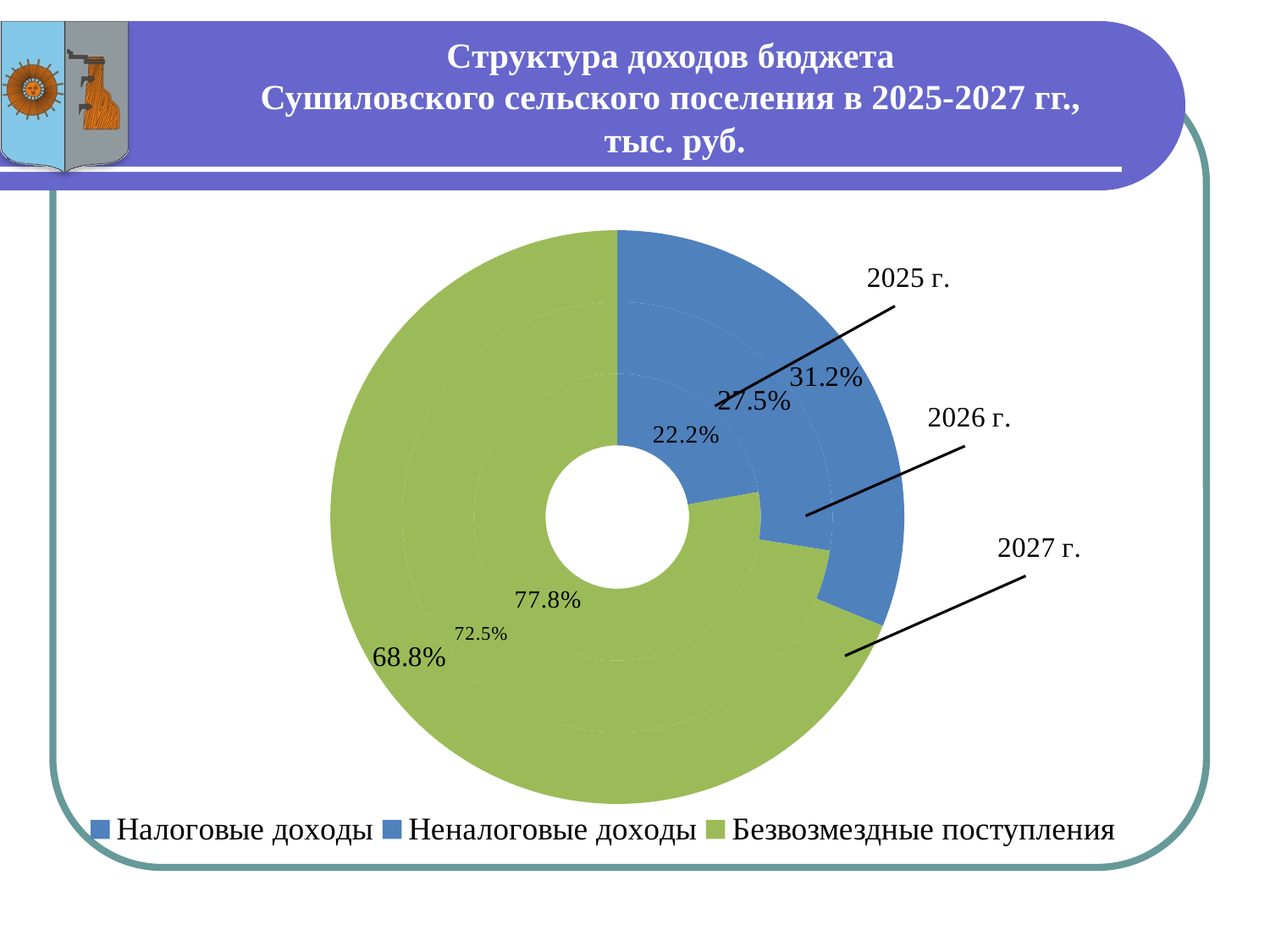
How many series does the legend list? 3 What share does the blue segment have in the middle ring (2026 г.)? 27.5% What share does the green segment have in the outermost ring (2027 г.)? 68.8% What kind of chart is shown on the slide? Doughnut (pie) chart What is the title of the chart? Структура доходов бюджета Сушиловского сельского поселения в 2025-2027 гг., тыс. руб. What share does the blue segment have in the outermost ring (2027 г.)? 31.2% What is the difference between the green and blue shares in the innermost ring (2025 г.)? 55.6% Which legend entry is shown in green? Безвозмездные поступления Does the blue segment's share rise or fall from the innermost ring (2025 г.) to the outermost ring (2027 г.)? Rise